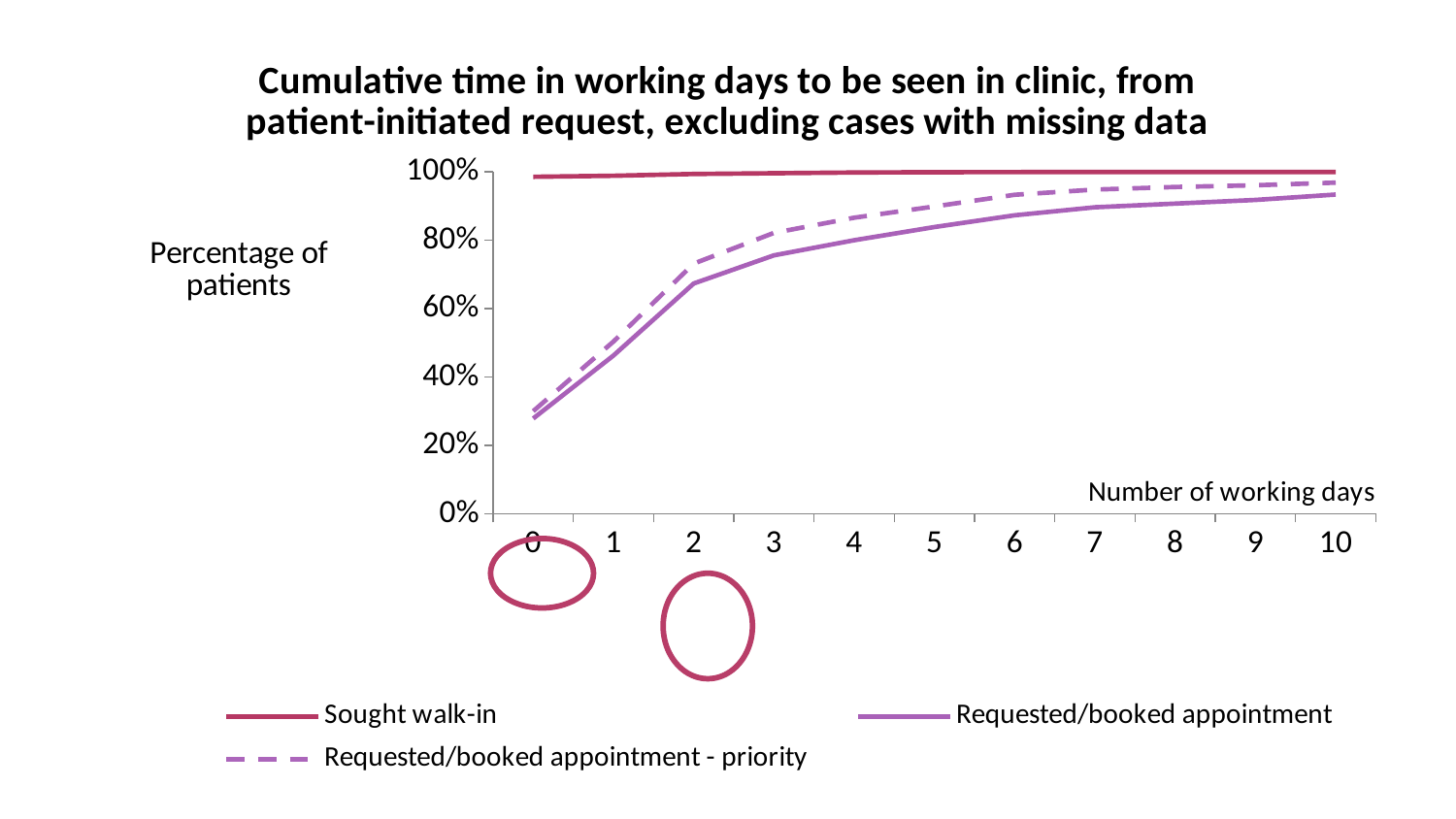
How many working-day values are marked along the x axis? 11 How many series does the legend list? 3 At 2 working days, which is higher: Requested/booked appointment or Requested/booked appointment - priority? Requested/booked appointment - priority Is the value for Requested/booked appointment at 2 working days greater or less than 60%? greater Is the value for Sought walk-in at 0 working days greater or less than 80%? greater Does the Requested/booked appointment line rise or fall as the number of working days increases? rises Which series has the lowest value at 10 working days? Requested/booked appointment What is the label on the vertical axis of the chart? Percentage of patients What kind of chart is shown on the slide? line chart Is the value for Requested/booked appointment at 0 working days greater or less than 40%? less Which series has the highest value at 0 working days? Sought walk-in